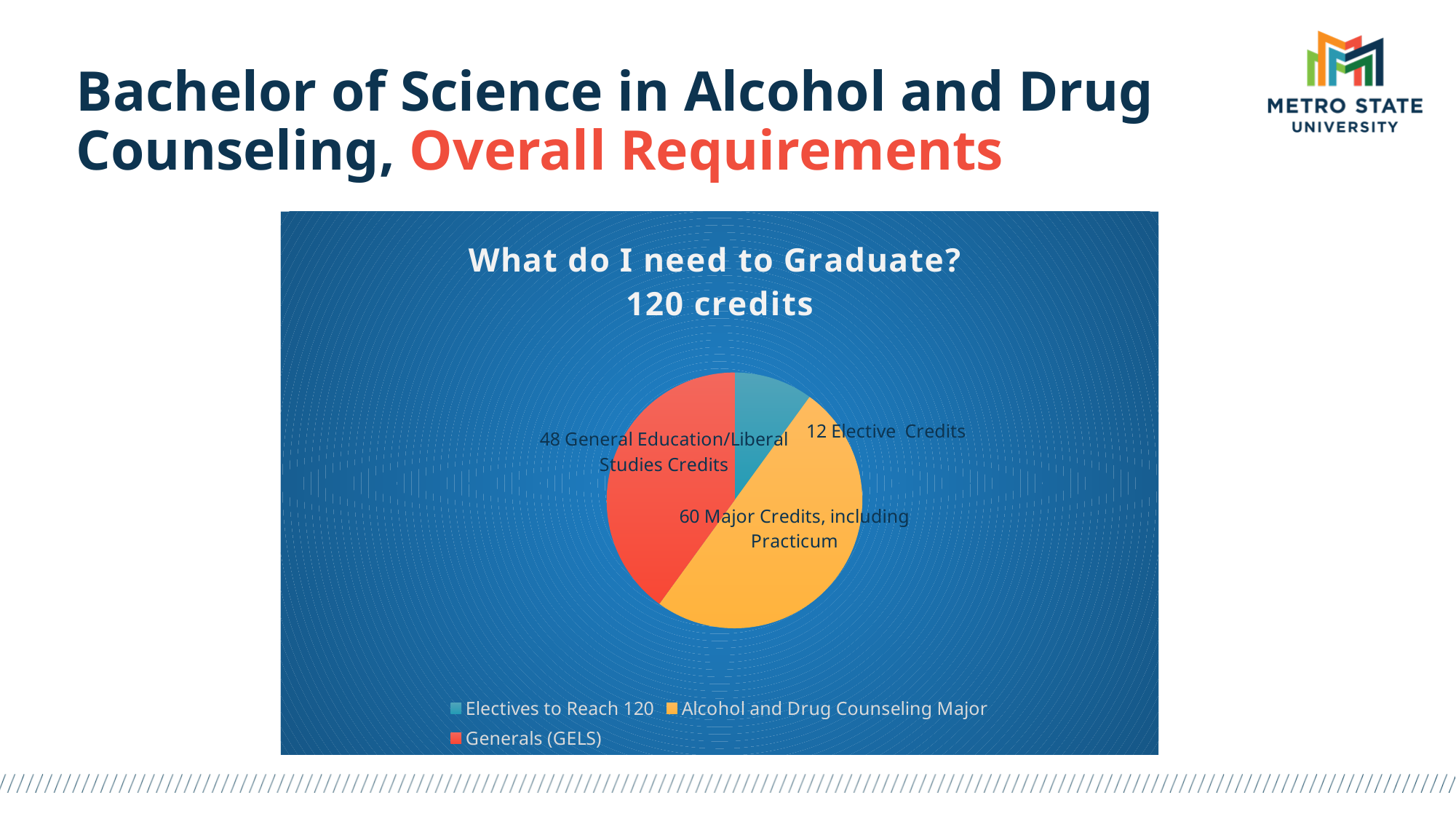
Which is larger: the Generals (GELS) slice or the Electives to Reach 120 slice? Generals (GELS) What is the title of the chart? What do I need to Graduate? 120 credits How many credits does the Electives to Reach 120 slice represent? 12 What kind of chart is shown on the slide? pie chart What is the difference in credits between the Major slice and the General Education/Liberal Studies slice? 12 How many slices does the pie chart have? 3 Which slice of the pie is the smallest? Electives to Reach 120 Which slice of the pie is the largest? Alcohol and Drug Counseling Major How many credits does the Alcohol and Drug Counseling Major slice represent? 60 How many entries does the legend list? 3 How many credits does the Generals (GELS) slice represent? 48 What share of the 120 total credits does the 60 Major Credits slice represent? 50%